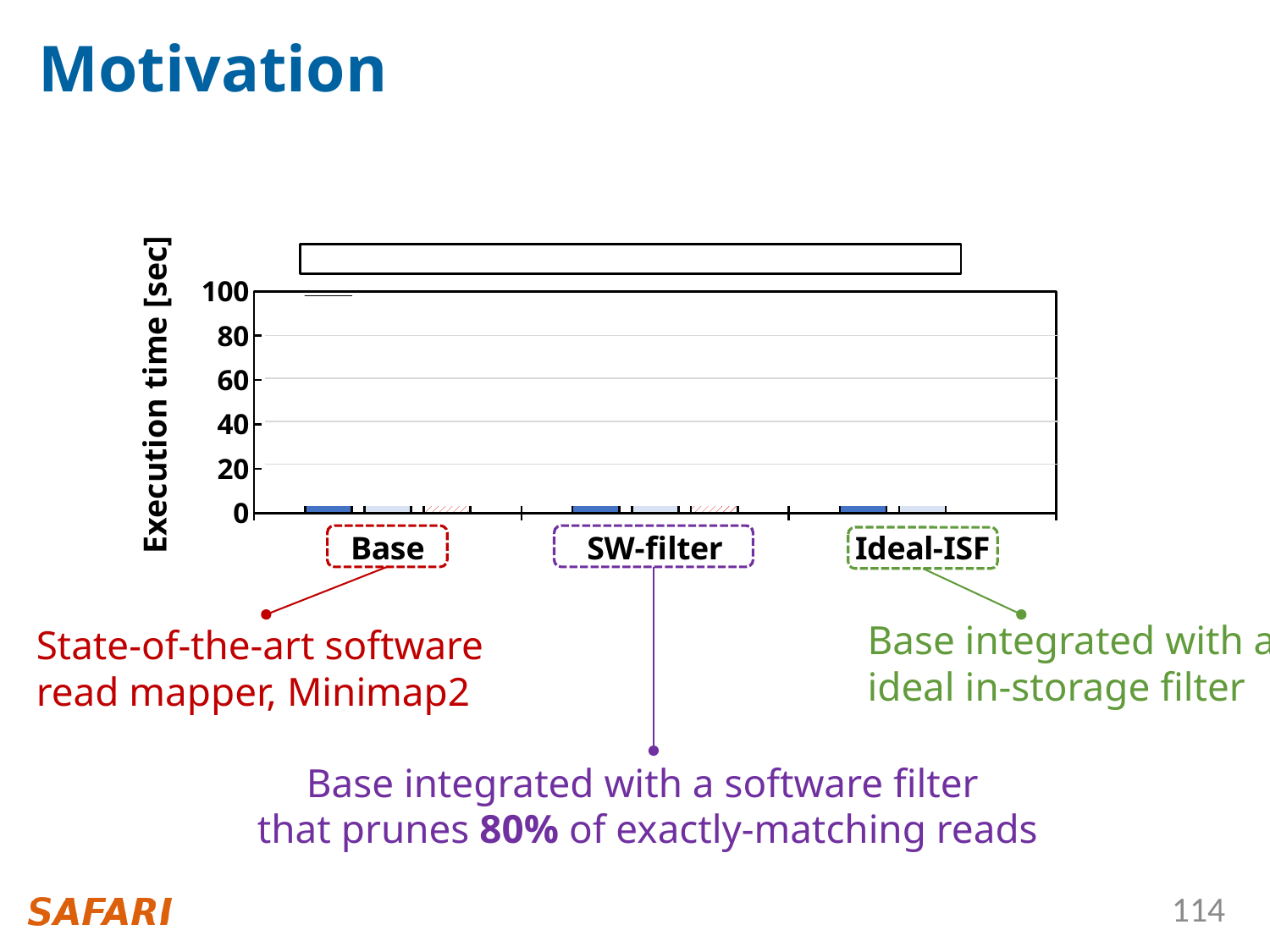
What is the label of the y axis of the chart? Execution time [sec] What kind of chart is shown on the slide? bar chart What is the highest tick value shown on the y axis of the chart? 100 How many categories are shown on the x axis of the chart? 3 Which category is listed last on the x axis of the chart? Ideal-ISF Which category is listed first on the x axis of the chart? Base